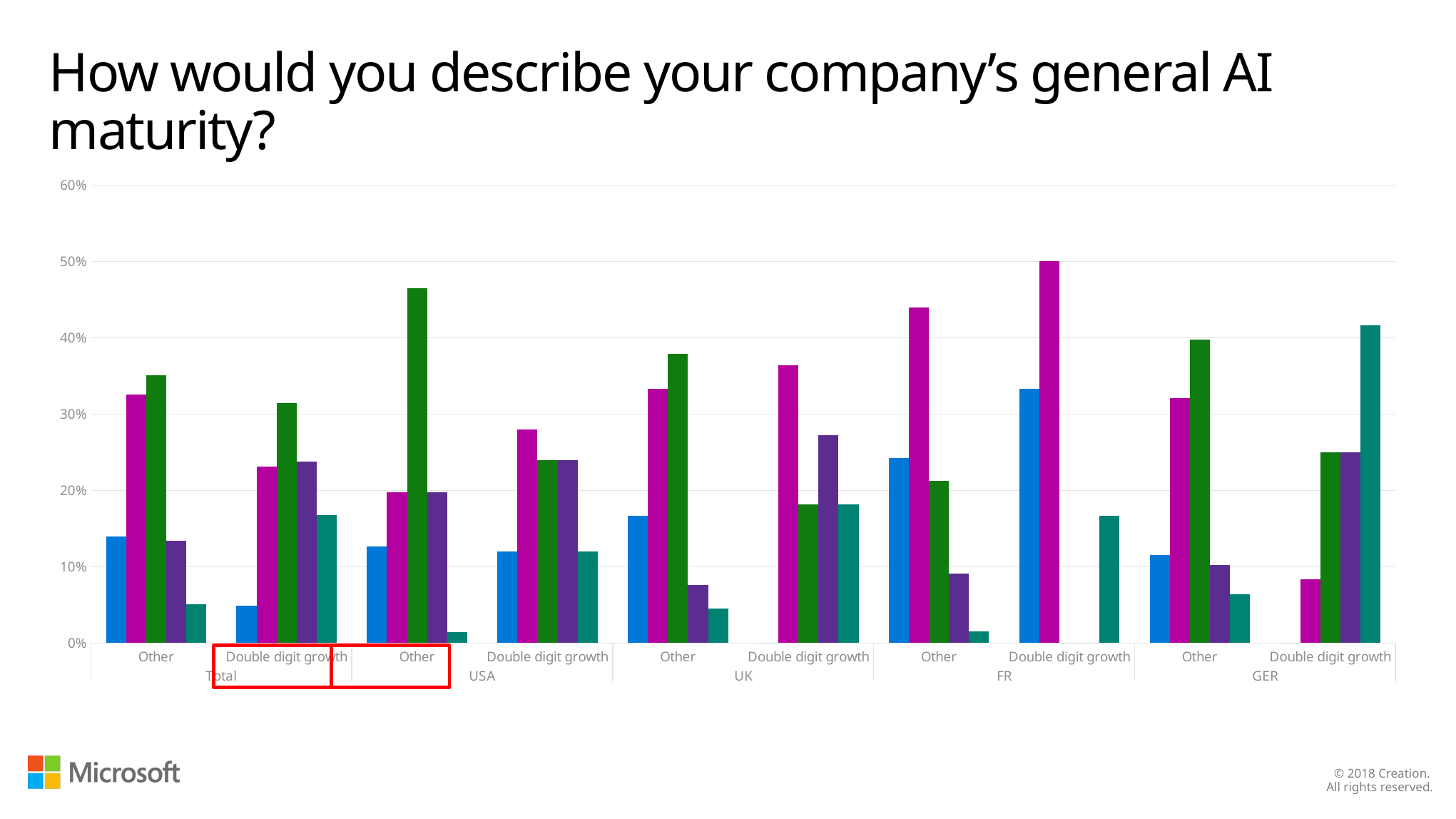
How many category labels (Other / Double digit growth) are there along the x axis in total? 10 Is the value of the teal bar for UK Double digit growth greater or less than 10%? greater What kind of chart is shown on the slide? bar chart In the FR Double digit growth group, which is larger: the blue bar or the magenta bar? the magenta bar Is the value of the green bar for USA Other greater or less than 40%? greater In the UK Other group, which is larger: the green bar or the blue bar? the green bar In the GER Other group, which colour bar is the tallest? green What is the title of the chart on the slide? How would you describe your company's general AI maturity? Is the value of the blue bar for Total Other greater or less than 20%? less How many different bar colours are plotted in each category group? 5 How many country/region groups are labelled along the x axis? 5